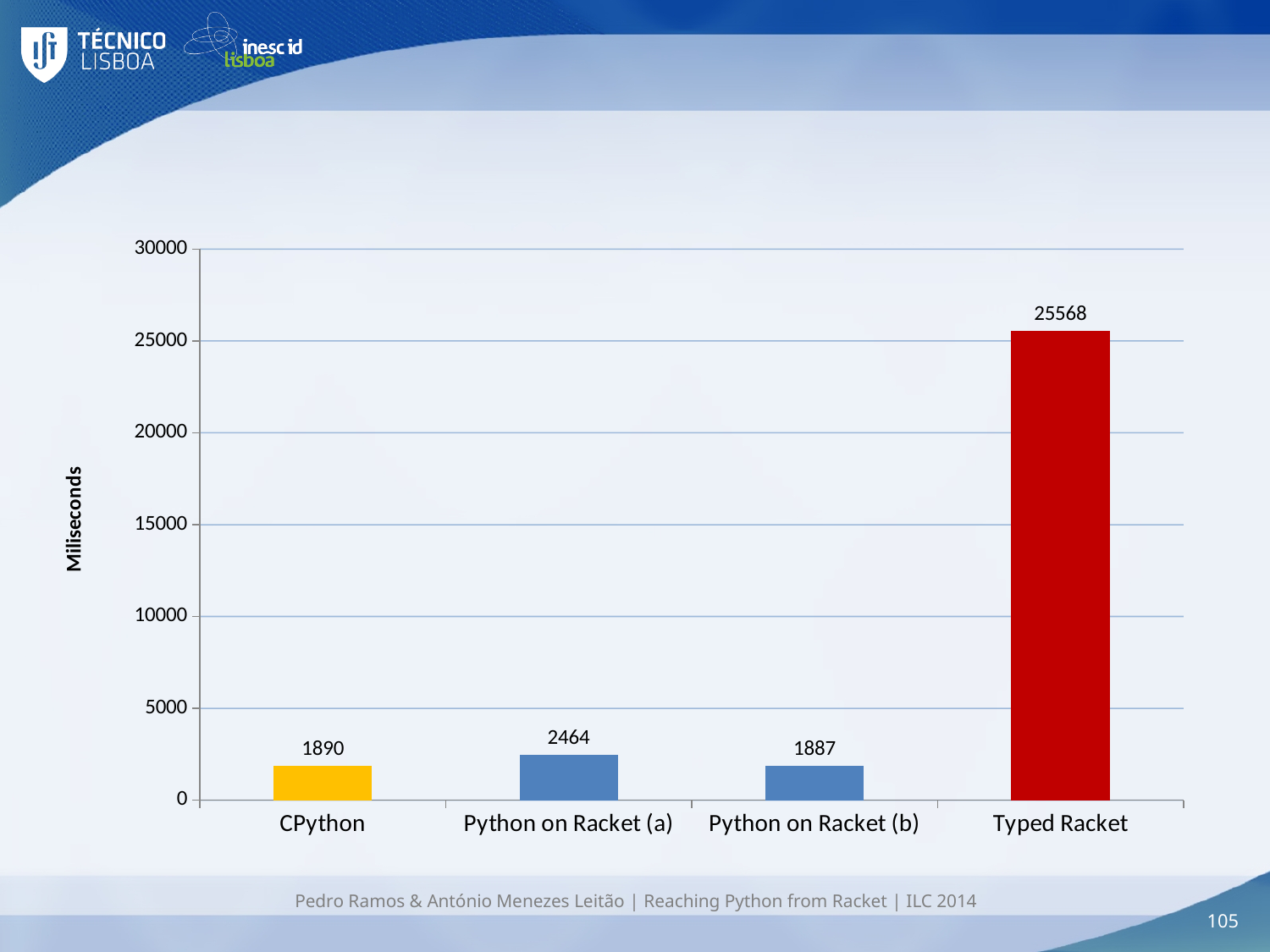
Is the value for Python on Racket (a) greater or less than 5000? less What is the difference between the values for Typed Racket and CPython? 23678 How many categories are shown on the x axis? 4 What kind of chart is shown on the slide? bar chart What is the value for Python on Racket (a)? 2464 What is the value for CPython? 1890 What is the value for Python on Racket (b)? 1887 What is the difference between the values for Python on Racket (a) and Python on Racket (b)? 577 Which is larger, the value for Python on Racket (a) or the value for CPython? Python on Racket (a) What is the value for Typed Racket? 25568 Is the value for Typed Racket greater or less than 20000? greater Which category has the highest value? Typed Racket